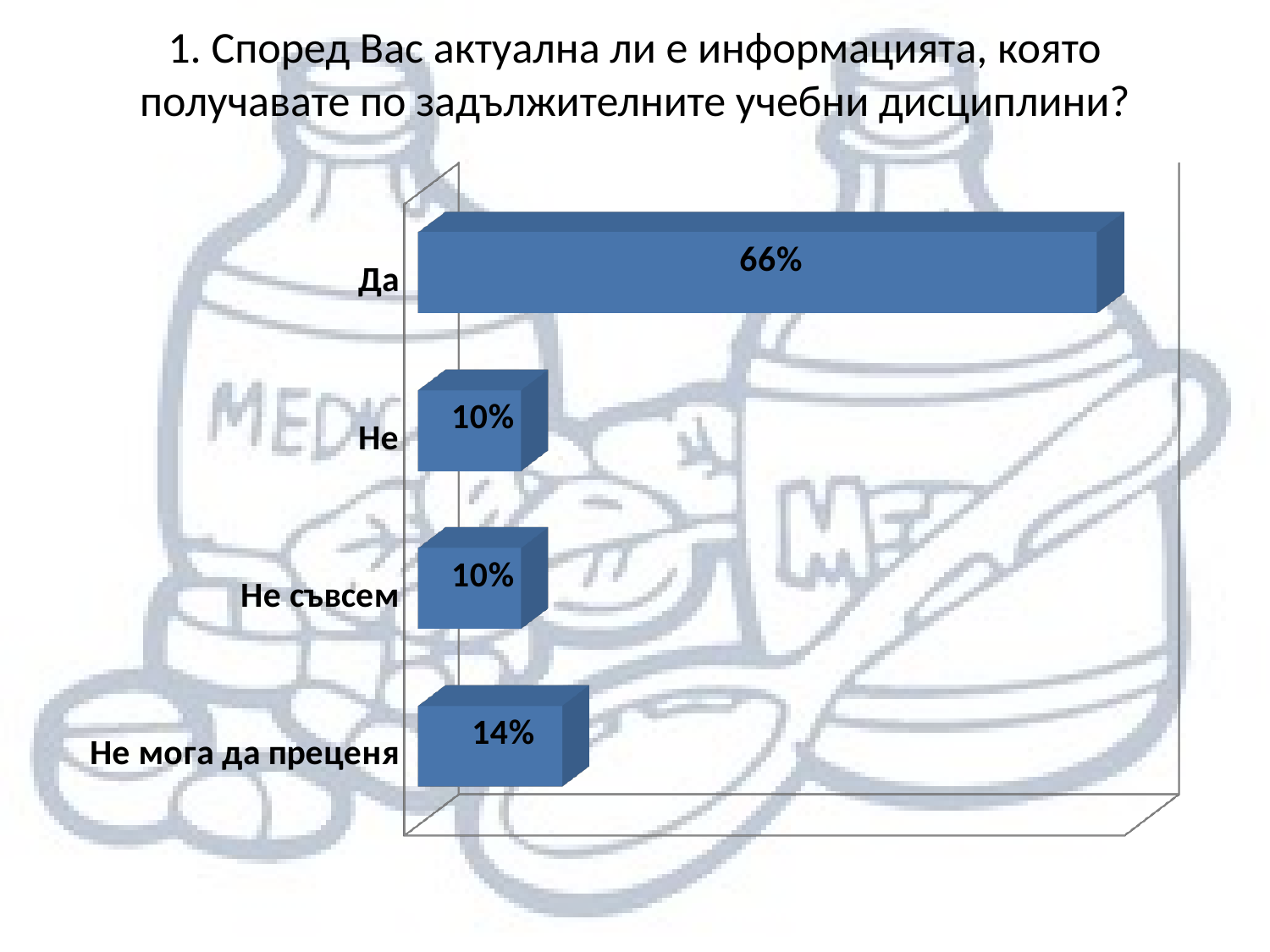
What is the difference between the values for "Да" and "Не мога да преценя"? 52% What is the total of the values for "Не" and "Не съвсем"? 20% Which is larger, the value for "Не мога да преценя" or the value for "Не съвсем"? Не мога да преценя What is the value for "Не съвсем"? 10% How many categories are shown in the chart? 4 What kind of chart is shown on the slide? bar chart What is the value for "Не мога да преценя"? 14% What is the difference between the values for "Не мога да преценя" and "Не"? 4% What is the value for "Да"? 66% Which two categories have the same value? Не and Не съвсем Which category has the highest value? Да